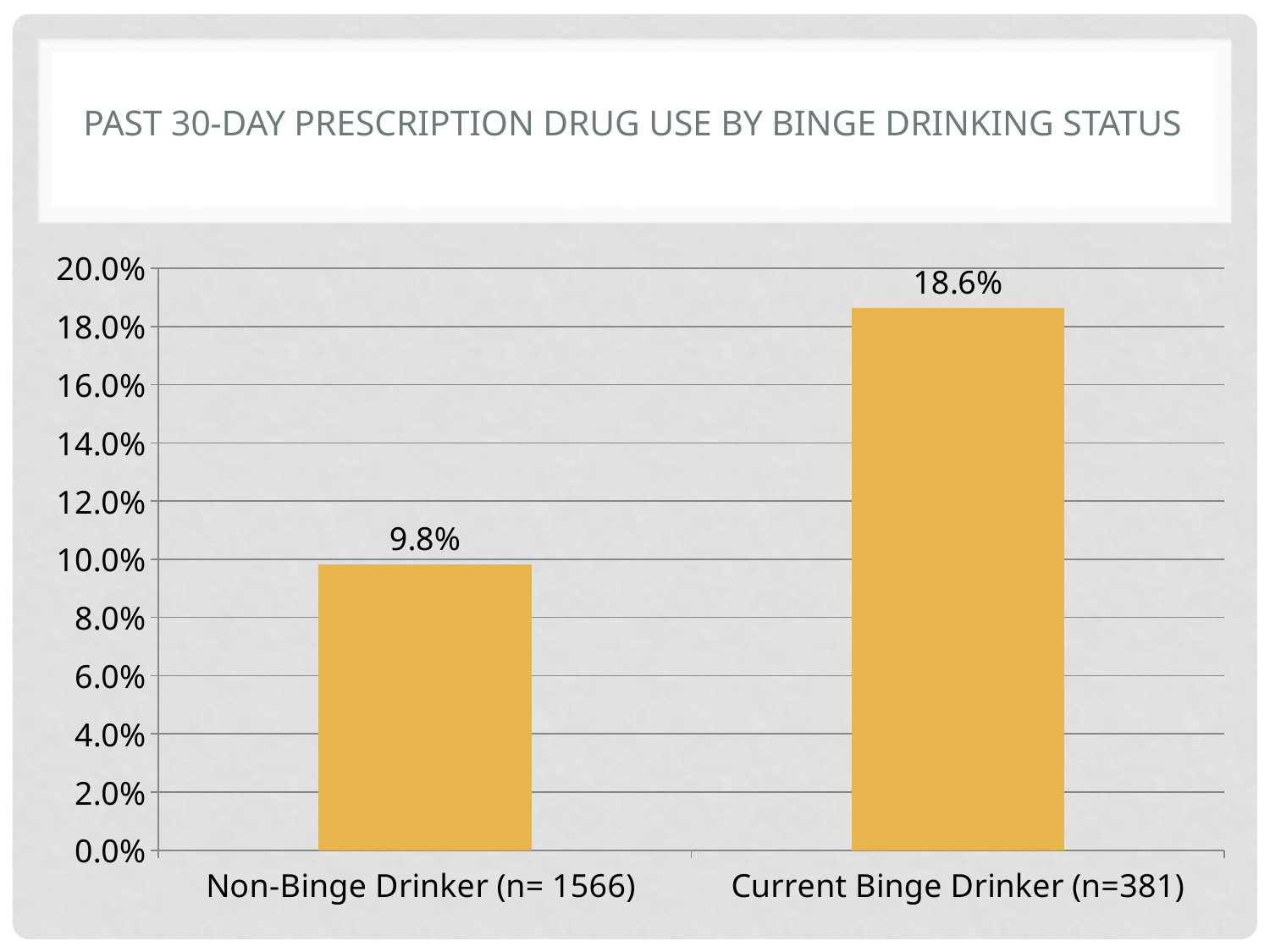
Is the value for Current Binge Drinkers greater or less than 18.0%? greater What is the difference between the values for Current Binge Drinkers and Non-Binge Drinkers? 8.8% How many categories are shown on the x axis? 2 What is the title of the chart? Past 30-Day Prescription Drug Use by Binge Drinking Status Is the value for Non-Binge Drinkers greater or less than 10.0%? less Which is larger: the value for Non-Binge Drinkers or the value for Current Binge Drinkers? Current Binge Drinker (n=381) What is the past 30-day prescription drug use value for Current Binge Drinkers (n=381)? 18.6% What is the maximum value shown on the y axis? 20.0% What kind of chart is shown on the slide? Bar chart Which category has the lowest value? Non-Binge Drinker (n= 1566) What is the past 30-day prescription drug use value for Non-Binge Drinkers (n= 1566)? 9.8% Which category has the highest value? Current Binge Drinker (n=381)